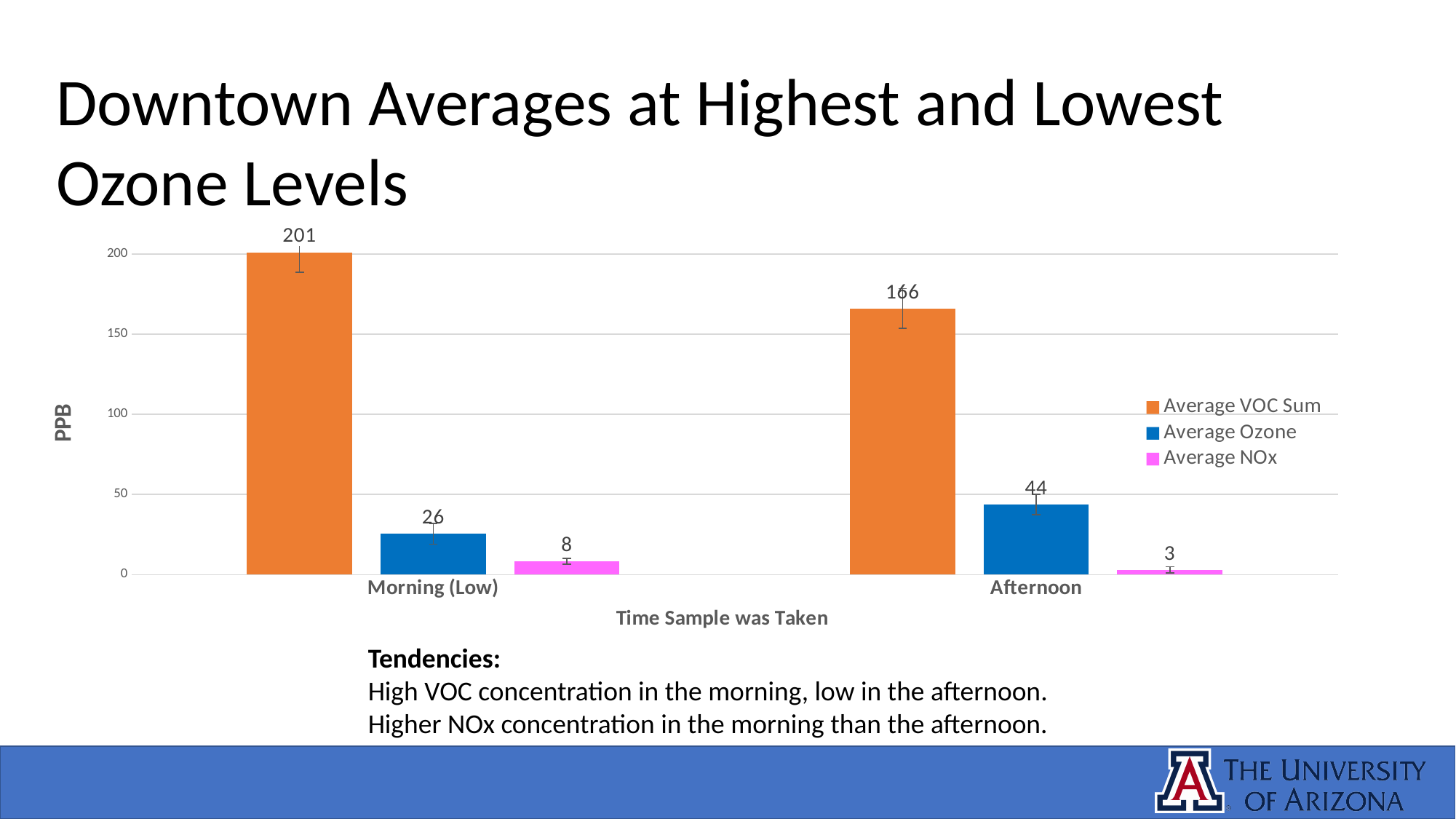
Is the Average Ozone value larger for Morning (Low) or Afternoon? Afternoon What is the Average Ozone value for Afternoon? 44 What kind of chart is shown on the slide? Bar chart What is the difference between the Average Ozone values for Afternoon and Morning (Low)? 18 How many series does the legend list? 3 What is the Average NOx value for Morning (Low)? 8 What is the Average VOC Sum value for Morning (Low)? 201 What is the label of the y axis? PPB What is the difference between the Average VOC Sum for Morning (Low) and Afternoon? 35 Which time sample has the lower Average NOx value? Afternoon Which time sample has the higher Average VOC Sum? Morning (Low) What is the Average VOC Sum value for Afternoon? 166